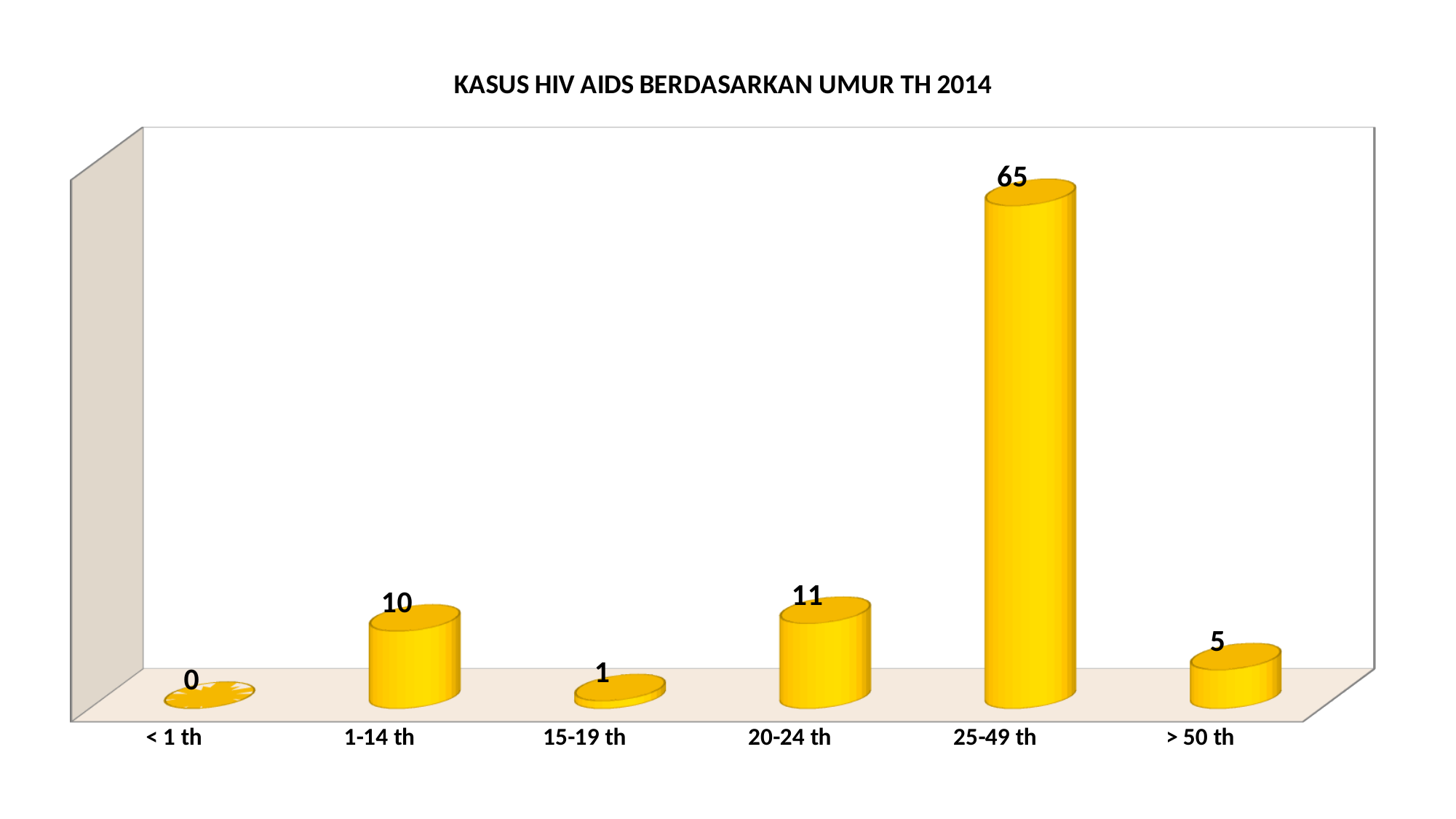
What is the value for the > 50 th age group? 5 How many age groups are shown on the x axis? 6 What is the value for the 25-49 th age group? 65 What is the difference between the values for 1-14 th and > 50 th? 5 What is the value for the 1-14 th age group? 10 Which age group has the lowest number of cases? < 1 th What kind of chart is shown on the slide? Bar chart What is the difference between the values for 25-49 th and 20-24 th? 54 What is the value for the < 1 th age group? 0 Which age group has the highest number of cases? 25-49 th What is the title of the chart? KASUS HIV AIDS BERDASARKAN UMUR TH 2014 Which is larger, the value for 20-24 th or the value for 15-19 th? 20-24 th